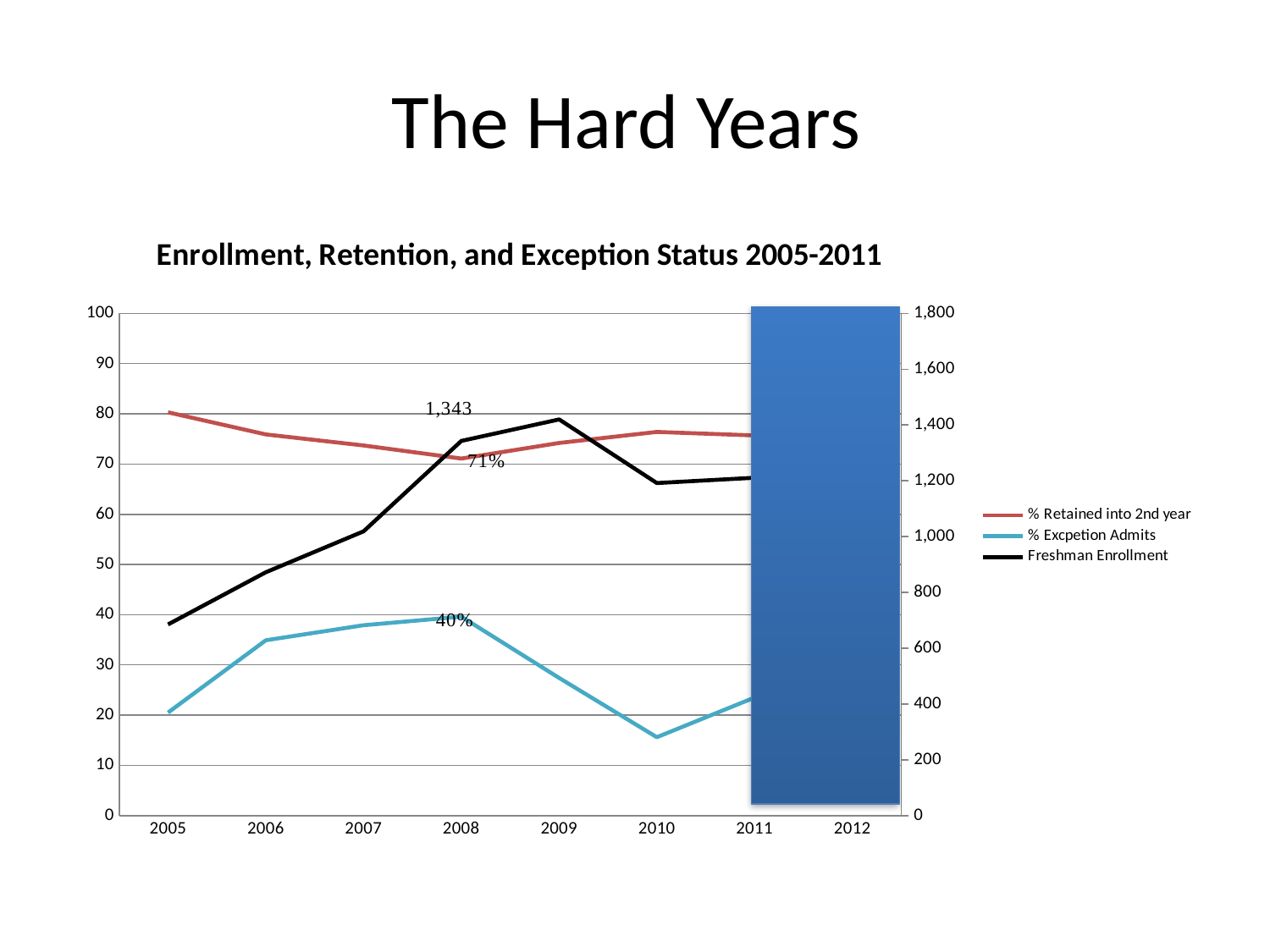
In which year is Freshman Enrollment highest? 2009 Which is higher for % Retained into 2nd year: 2005 or 2011? 2005 How many series does the legend list? 3 What is the % Retained into 2nd year value labeled for 2008? 71% In which year is % Excpetion Admits lowest? 2010 What is the % Excpetion Admits value labeled for 2008? 40% In which year is Freshman Enrollment lowest? 2005 What kind of chart is shown on the slide? line chart Is the Freshman Enrollment value for 2005 greater or less than 800? less Does % Excpetion Admits rise or fall from 2008 to 2010? fall What is the Freshman Enrollment value labeled for 2008? 1,343 Is the Freshman Enrollment value for 2010 greater or less than 1,000? greater